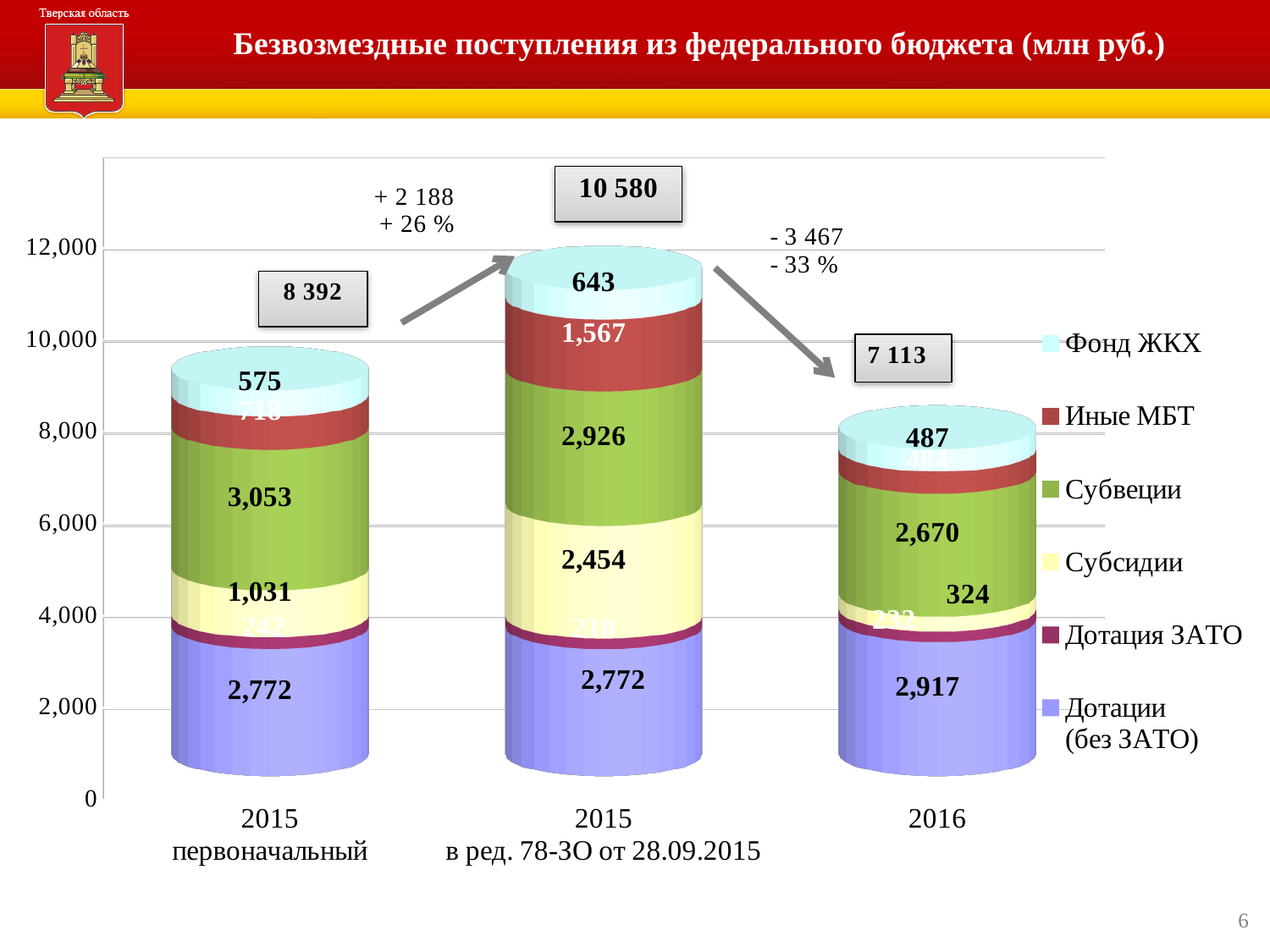
What is the value of Субсидии for 2015 в ред. 78-ЗО от 28.09.2015? 2,454 What is the value of Дотации (без ЗАТО) for 2016? 2,917 How many bars (categories) are plotted on the chart? 3 What is the value of Фонд ЖКХ for 2016? 487 Which category has the lowest total? 2016 What is the total shown for the 2015 в ред. 78-ЗО от 28.09.2015 bar? 10 580 How many series does the legend list? 6 Which is larger: Иные МБТ for 2015 в ред. 78-ЗО от 28.09.2015 or Фонд ЖКХ for 2015 в ред. 78-ЗО от 28.09.2015? Иные МБТ Which category has the highest total? 2015 в ред. 78-ЗО от 28.09.2015 What kind of chart is shown on the slide? stacked bar chart What is the difference between the Субсидии values for 2015 в ред. 78-ЗО от 28.09.2015 and 2016? 2,130 What is the value of Субвеции for 2015 первоначальный? 3,053